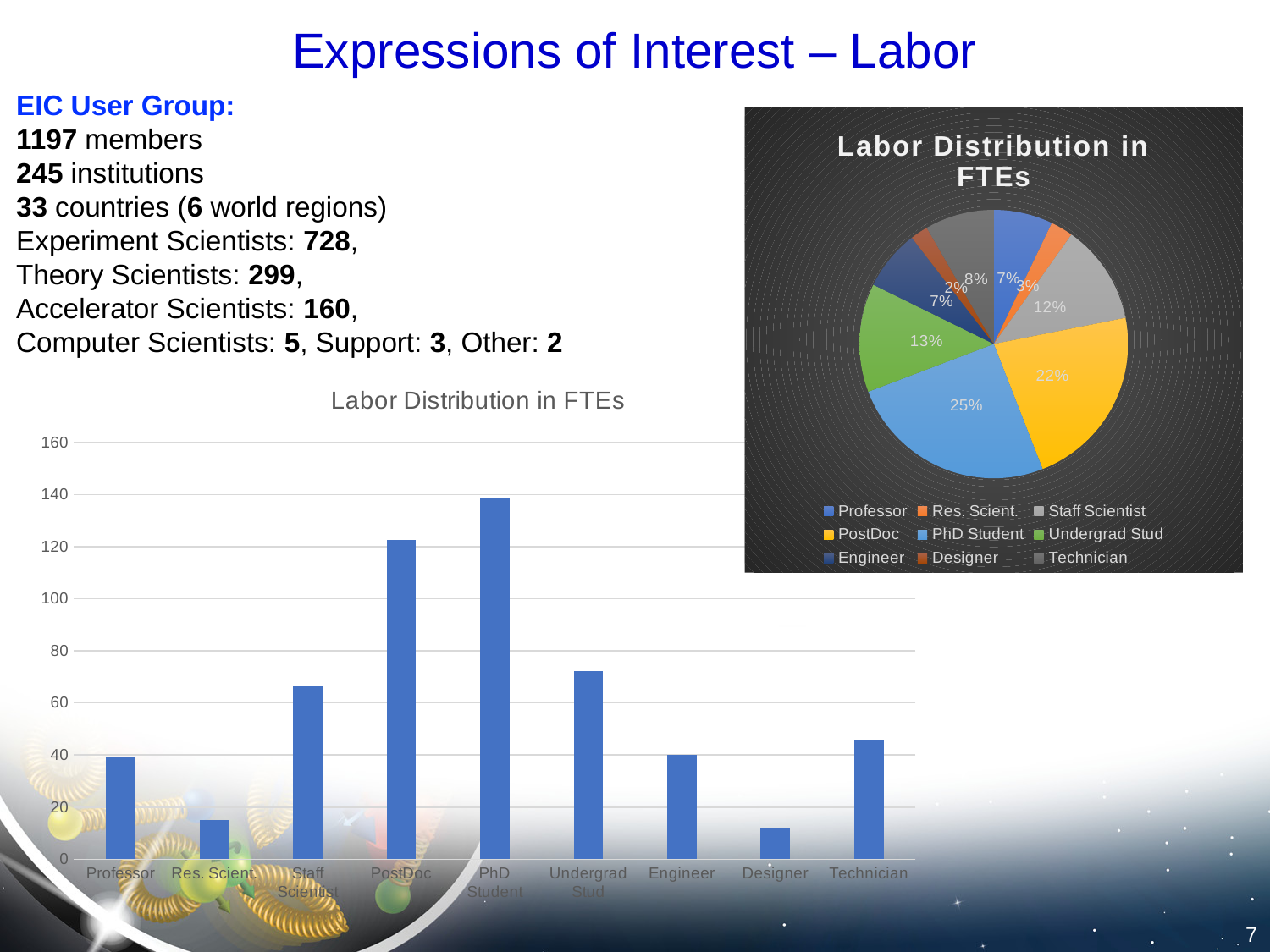
How many categories are shown on the x axis of the bar chart at the bottom left? 9 In the pie chart at the top right, what share does PhD Student have? 25% What kind of chart is the chart at the bottom left of the slide? bar chart In the bar chart at the bottom left, is the value for Engineer greater or less than 60? less In the bar chart at the bottom left, is the value for Undergrad Stud greater or less than 60? greater How many entries does the legend of the pie chart at the top right list? 9 In the bar chart at the bottom left, which category has the highest value? PhD Student In the bar chart at the bottom left, which is larger, the value for PostDoc or the value for Undergrad Stud? PostDoc What kind of chart is the chart at the top right of the slide? pie chart In the bar chart at the bottom left, is the value for PostDoc greater or less than 100? greater In the pie chart at the top right, what share does PostDoc have? 22% In the bar chart at the bottom left, which category has the lowest value? Designer